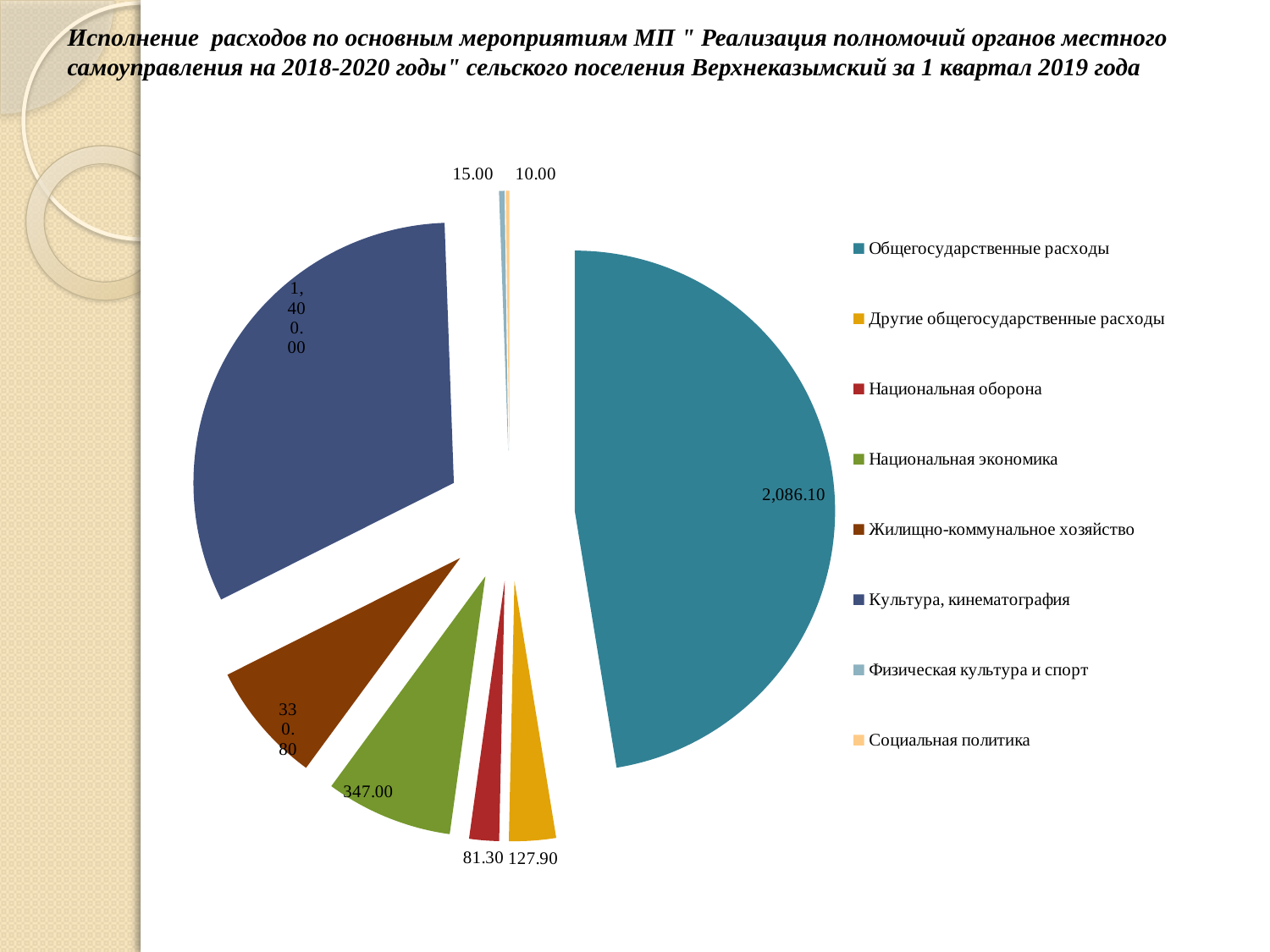
What is the difference between Другие общегосударственные расходы and Национальная оборона? 46.60 Which category has the largest slice? Общегосударственные расходы Which is larger, Национальная экономика or Жилищно-коммунальное хозяйство? Национальная экономика How many categories does the legend list? 8 What is the value for Национальная экономика? 347.00 What type of chart is shown on the slide? pie chart What is the value for Национальная оборона? 81.30 What is the value for Социальная политика? 10.00 What is the difference between Общегосударственные расходы and Культура, кинематография? 686.10 What is the value for Культура, кинематография? 1,400.00 Which category has the smallest slice? Социальная политика What is the value for Общегосударственные расходы? 2,086.10